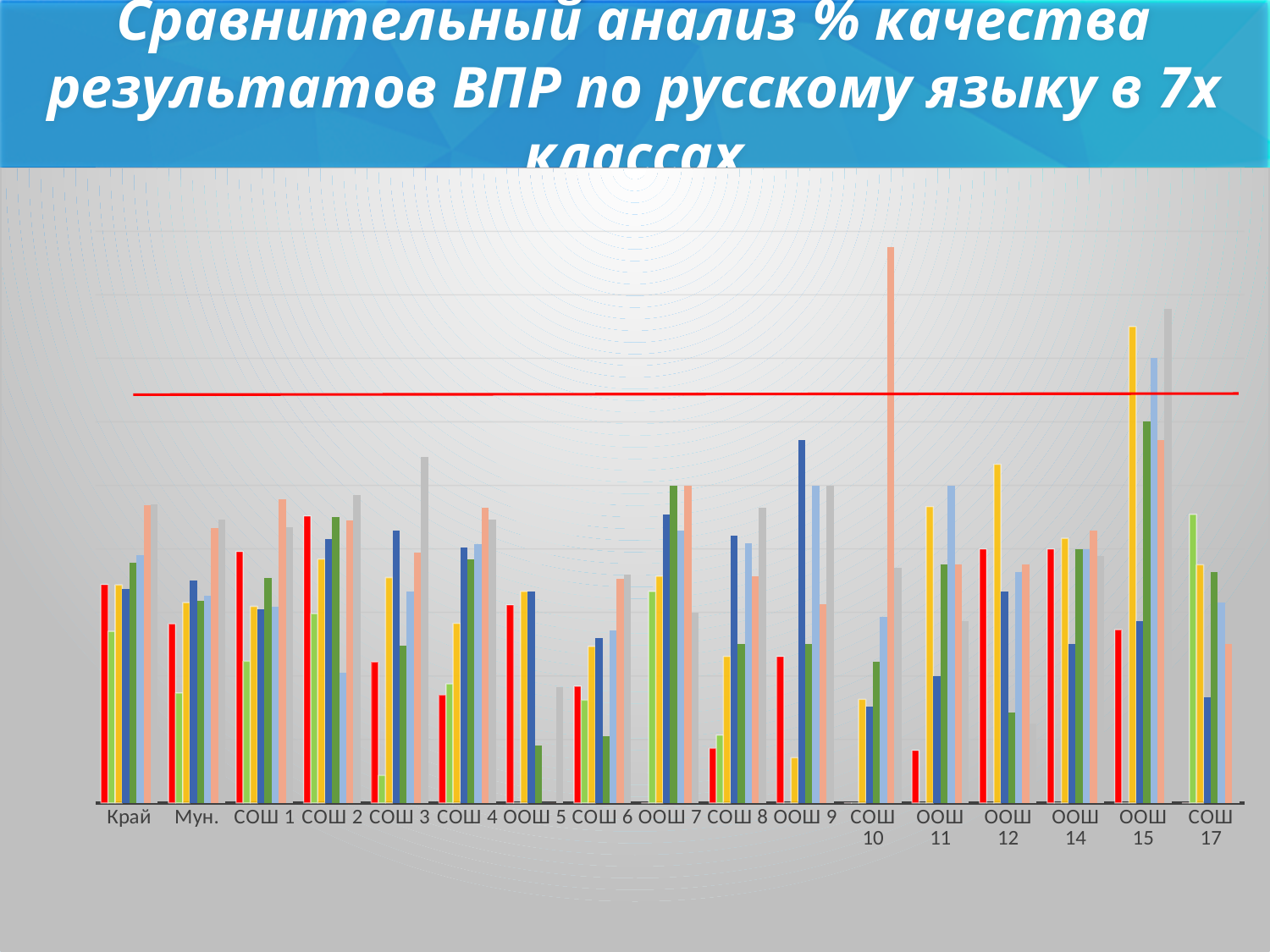
How many categories are shown along the x axis of the chart? 17 What is the last category on the x axis of the chart? СОШ 17 What kind of chart is shown on the slide? bar chart What is the first category on the x axis of the chart? Край Which category contains the tallest bar in the chart? СОШ 10